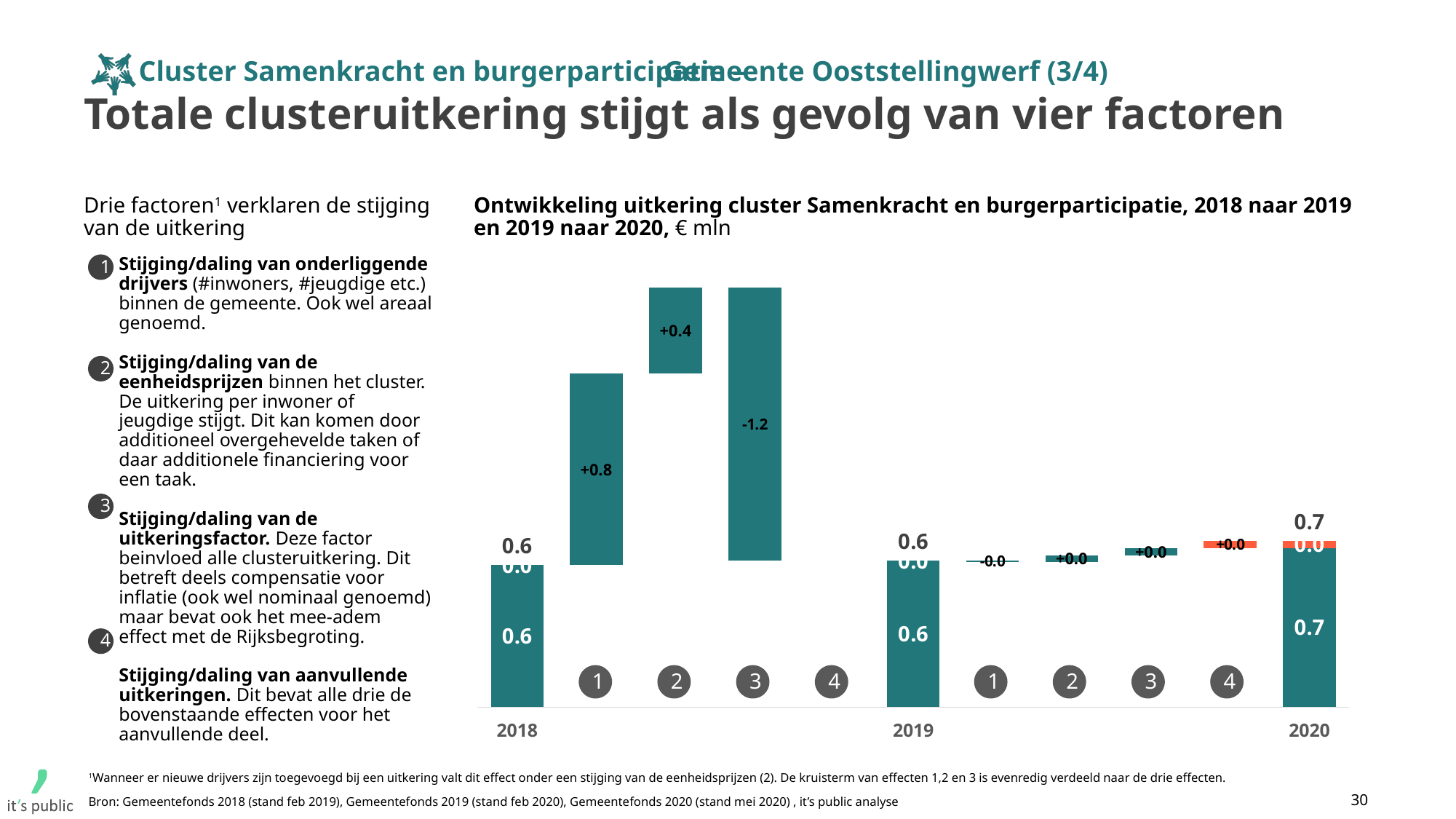
Which factor has the largest positive effect in the step from 2018 to 2019? Factor 1 In what unit are the values in the chart expressed? € mln What kind of chart is shown on the slide? bar chart (waterfall) What is the value of factor 3 in the step from 2018 to 2019? -1.2 What is the total uitkering for 2020 in the chart? 0.7 What is the value of factor 1 in the step from 2018 to 2019? +0.8 What is the total uitkering for 2018 in the chart? 0.6 What is the difference between the 2020 total and the 2018 total? 0.1 Which is larger, the total for 2018 or the total for 2020? 2020 Which factor has the lowest (most negative) value in the step from 2018 to 2019? Factor 3 What is the value of factor 2 in the step from 2018 to 2019? +0.4 How many year totals (2018, 2019, 2020) are shown in the chart? 3